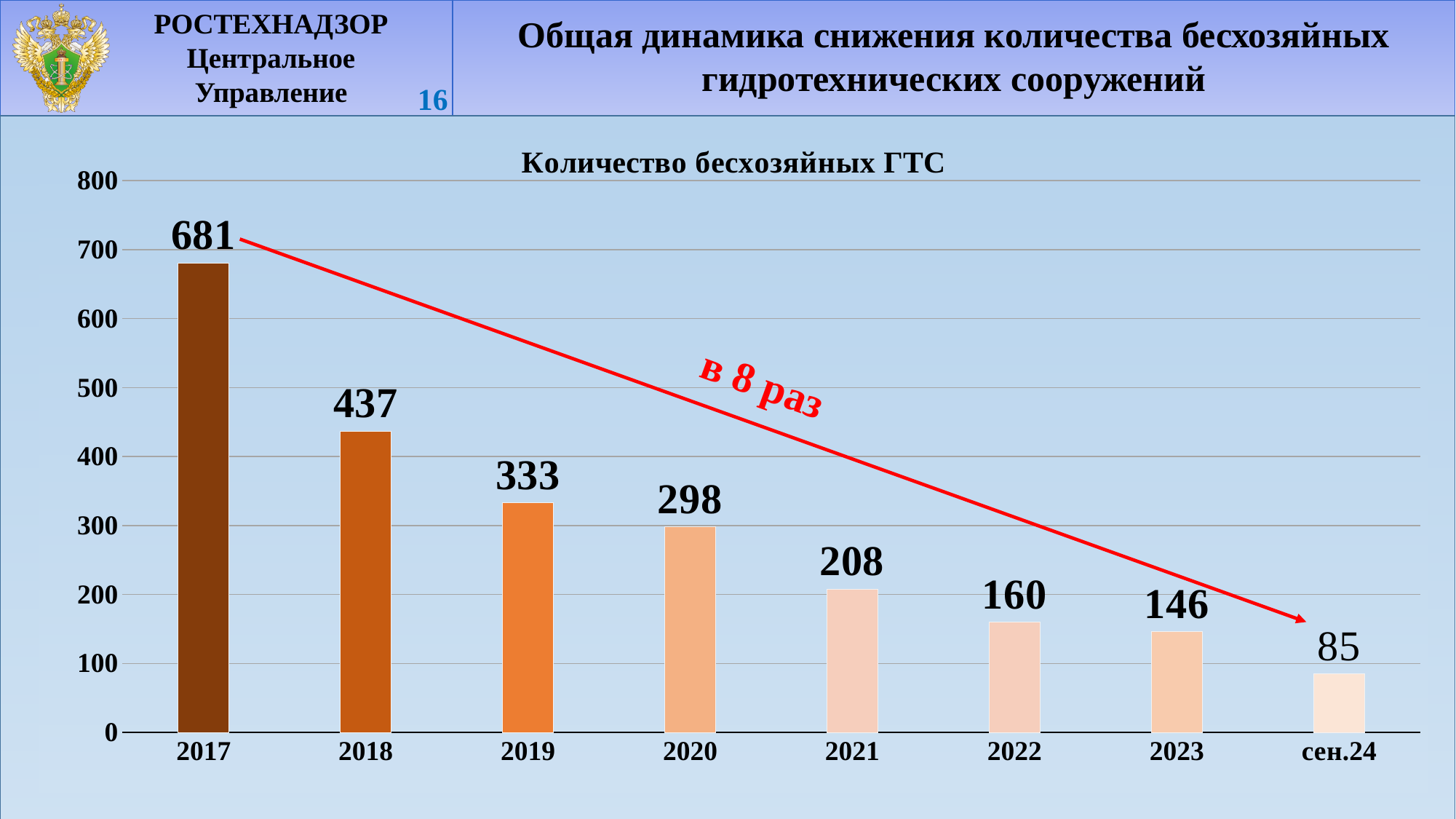
Which category has the highest value? 2017 Which is larger, the value for 2019 or the value for 2021? 2019 What kind of chart is shown on the slide? bar chart Do the values rise or fall from 2017 to сен.24? fall How many categories are shown on the x axis? 8 What is the value for сен.24? 85 What is the difference between the values for 2017 and 2018? 244 Is the value for 2021 greater or less than 300? less What is the value for 2020? 298 What is the difference between the values for 2022 and 2023? 14 What is the value for 2017? 681 Which category has the lowest value? сен.24